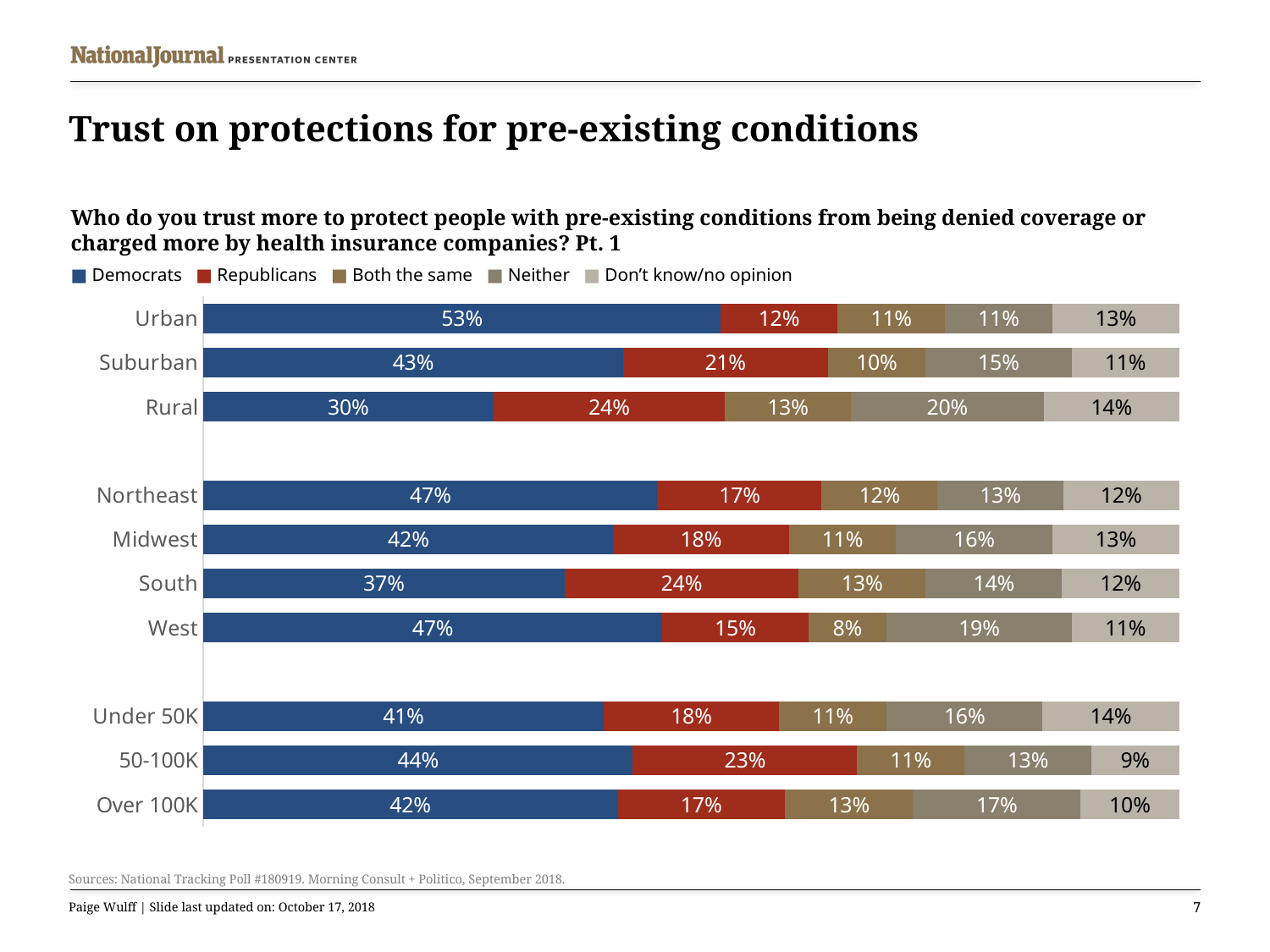
How many series does the legend list? 5 Which has a larger Democrats value, Northeast or South? Northeast What kind of chart is shown on the slide? Stacked bar chart How many percentage points higher is the Democrats value for Urban than for Rural? 23 Which category has the lowest Democrats value? Rural Which category has the highest Democrats value? Urban What is the total of the Urban bar across all five series? 100% What is the Don't know/no opinion value for the 50-100K category? 9% How many categories are shown on the chart? 10 What is the Republicans value for the Rural category? 24% What percentage of Urban respondents trust Democrats more? 53% What is the Neither value for the West category? 19%